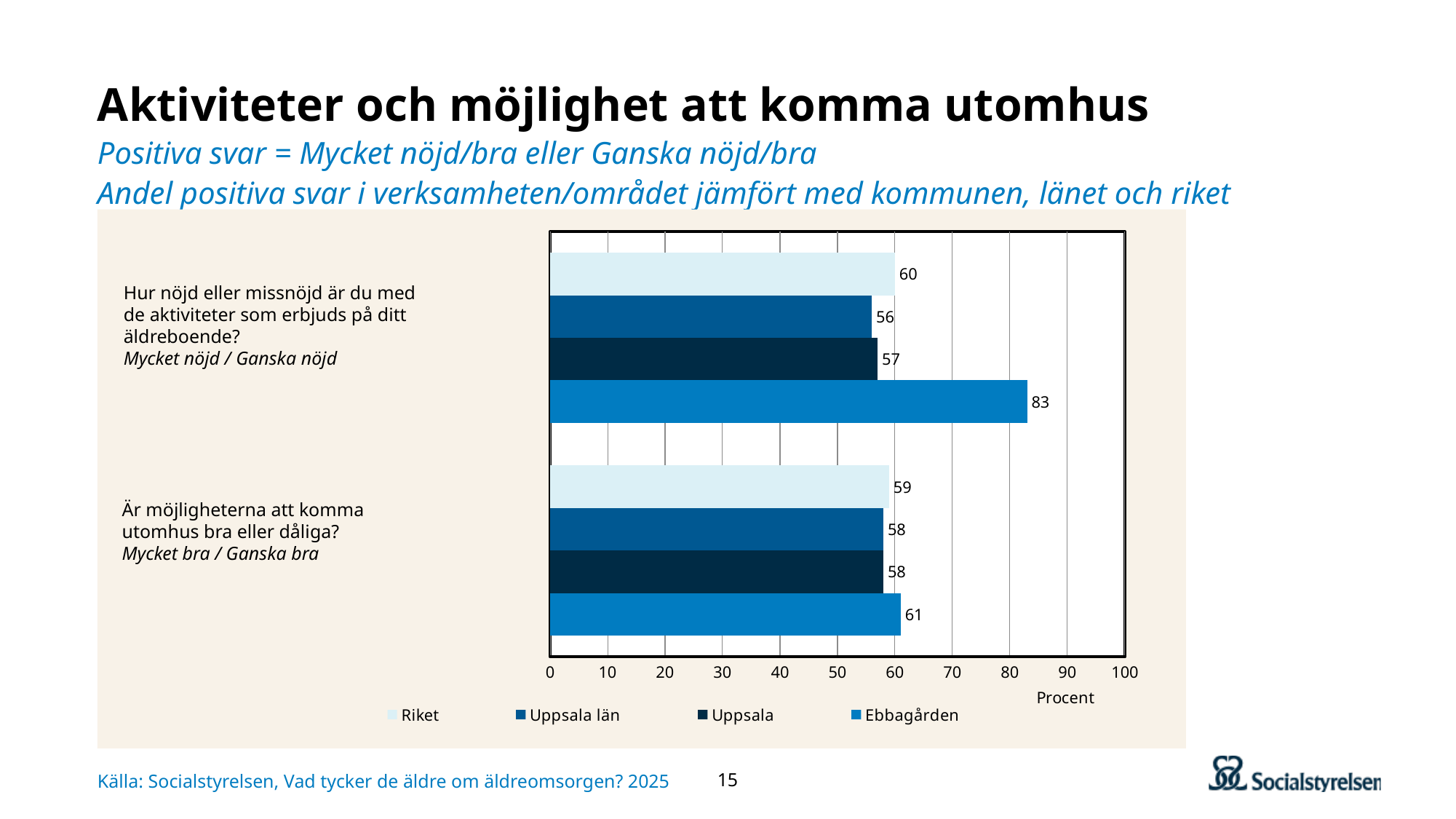
What is the difference between Ebbagården and Riket on the question about satisfaction with activities offered? 23 What kind of chart is shown on the slide? Bar chart What is the difference between Ebbagården and Uppsala on the question about the possibilities to get outdoors? 3 How many series does the legend list? 4 Which series has the highest value on the question about satisfaction with activities offered? Ebbagården What is the value for Riket on the question about the possibilities to get outdoors? 59 Is the value for Ebbagården on the activities question greater or less than 80? greater Which is larger on the question about the possibilities to get outdoors: Ebbagården or Riket? Ebbagården What unit is shown on the x axis of the chart? Procent What is the value for Ebbagården on the question about satisfaction with activities offered at the care home? 83 Which series has the lowest value on the question about satisfaction with activities offered? Uppsala län What is the value for Uppsala län on the question about satisfaction with activities offered? 56